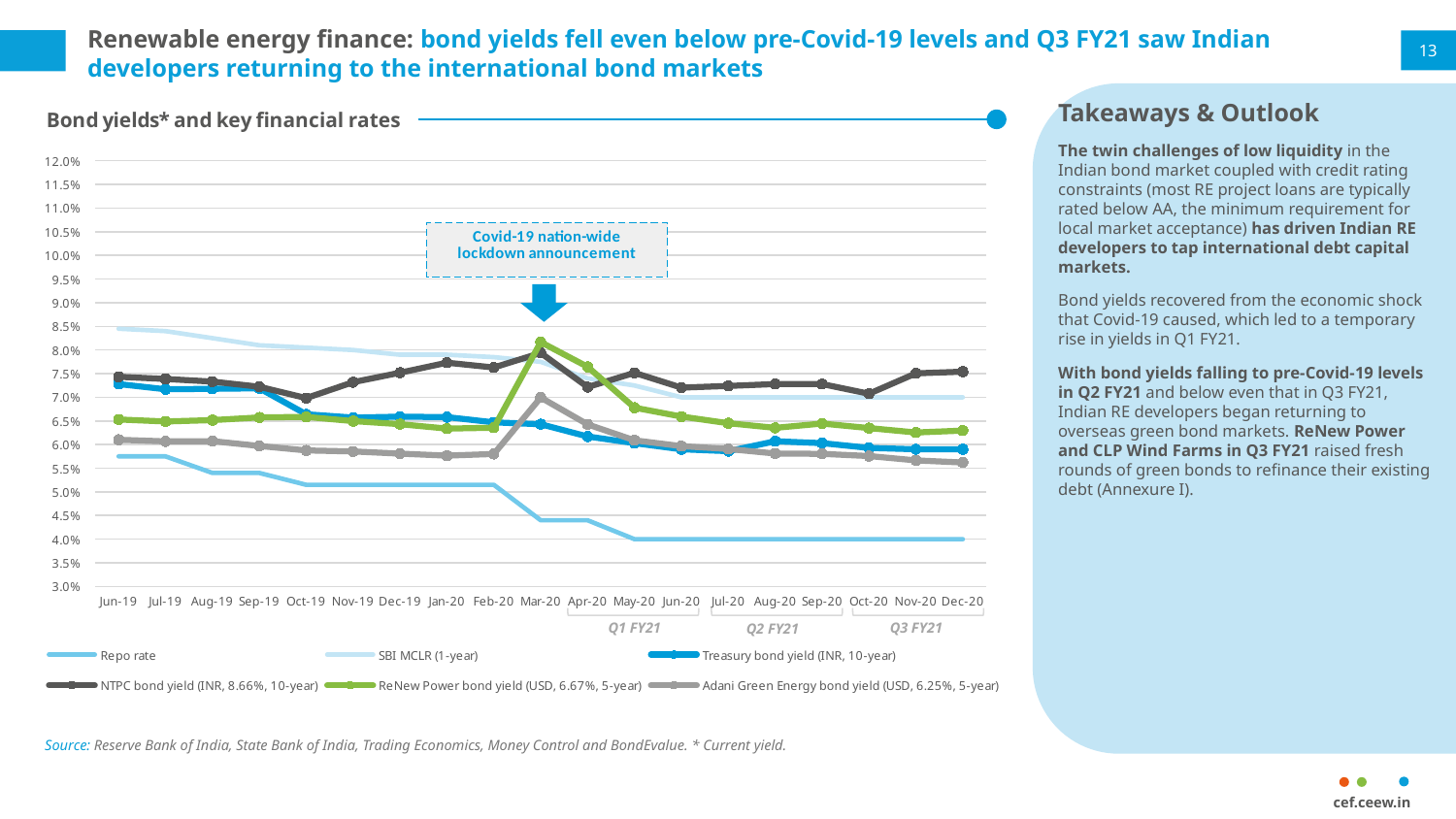
In Dec-20, which is larger: the NTPC bond yield or the ReNew Power bond yield? NTPC bond yield Which month does the 'Covid-19 nation-wide lockdown announcement' annotation point to? Mar-20 Which series has the highest value in Jun-19? SBI MCLR (1-year) Is the SBI MCLR (1-year) value in Jun-19 greater or less than 8.0%? greater Is the Adani Green Energy bond yield in Dec-20 greater or less than 6.0%? less How many months are plotted along the x axis of the chart? 19 Does the Repo rate rise or fall from Jun-19 to Dec-20? Fall Which series has the lowest value in Dec-20? Repo rate What kind of chart is shown on the slide? Line chart Which series reaches the highest value in Mar-20? ReNew Power bond yield (USD, 6.67%, 5-year) How many series does the legend of the chart list? 6 What is the title of the chart? Bond yields* and key financial rates